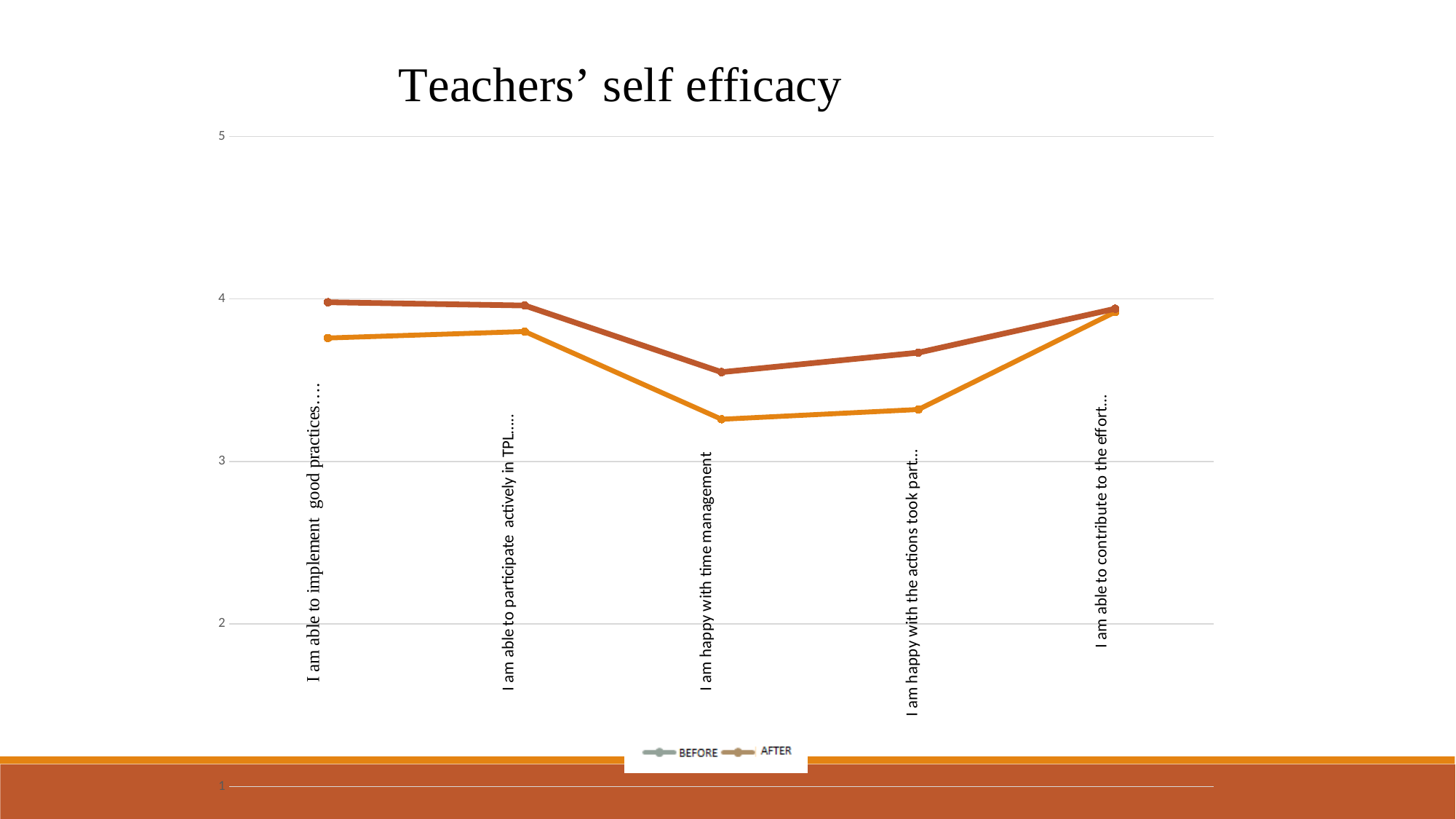
For both series, is the value at 'I am able to participate actively in TPL' higher or lower than at 'I am happy with time management'? higher Is the value for 'I am happy with the actions took part' greater or less than 4 for both series? less What are the two series named in the legend? BEFORE and AFTER Is the value for 'I am happy with time management' greater or less than 4 for both series? less How many categories are plotted along the x axis? 5 Do the values rise or fall from 'I am happy with the actions took part' to 'I am able to contribute to the effort'? rise What kind of chart is shown on the slide? line chart Do the values rise or fall from 'I am able to participate actively in TPL' to 'I am happy with time management'? fall How many series does the legend list? 2 Is the value for 'I am happy with time management' greater or less than 3 for both series? greater Which category has the lowest value for both series? I am happy with time management What is the title of the chart? Teachers' self efficacy